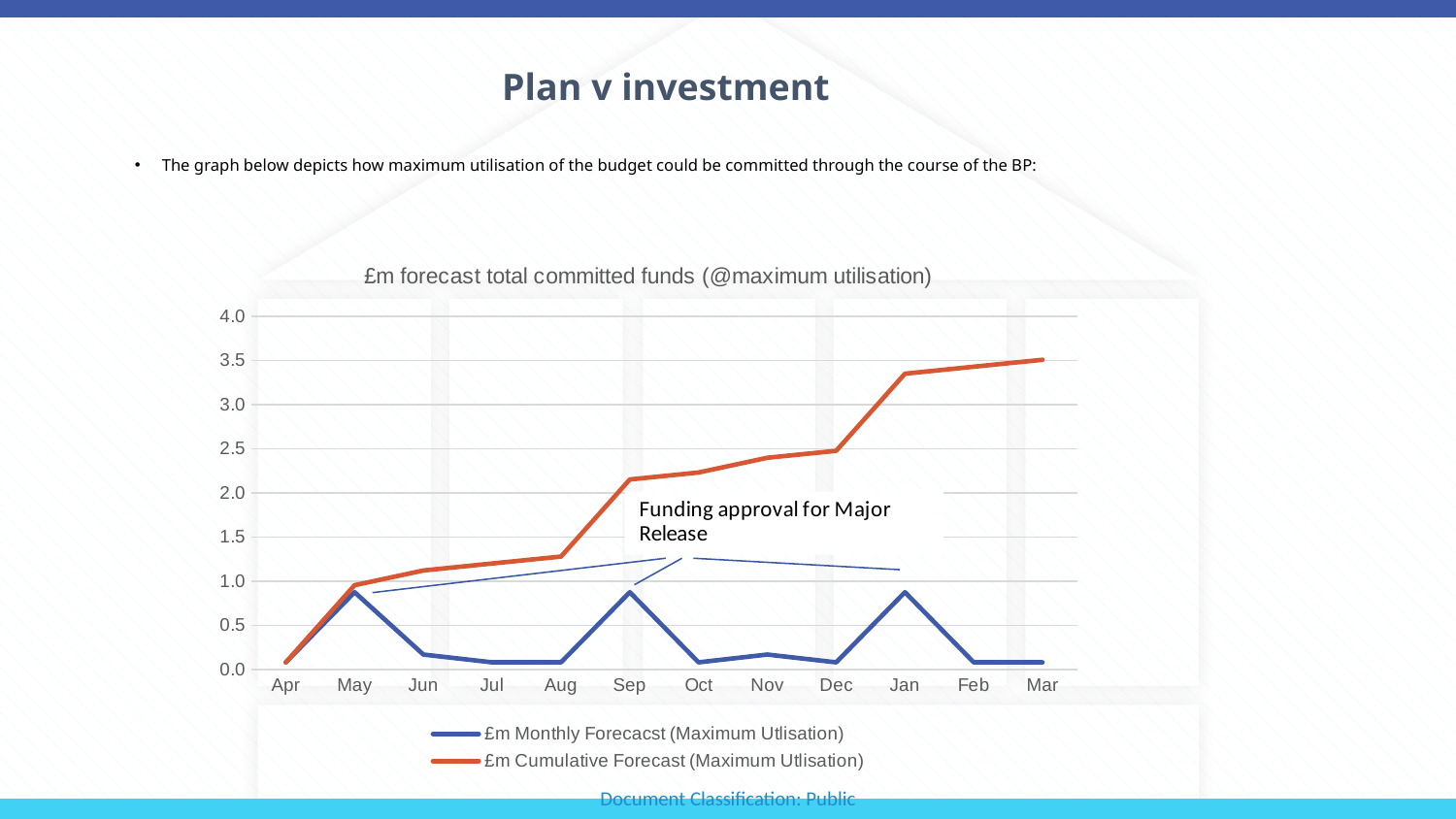
How many months are shown on the x axis? 12 Which month has the lowest value for the £m Cumulative Forecast series? Apr How many series does the legend list? 2 Which is larger: the £m Cumulative Forecast value for Jan or for Aug? Jan What kind of chart is shown on the slide? line chart Is the £m Cumulative Forecast value for Mar greater or less than 3.0? greater Is the £m Cumulative Forecast value for Dec greater or less than 3.0? less Is the £m Monthly Forecast value for Jul greater or less than 0.5? less Does the £m Cumulative Forecast series rise or fall from Apr to Mar? rise What is the title of the chart? £m forecast total committed funds (@maximum utilisation) Which month has the highest value for the £m Cumulative Forecast series? Mar